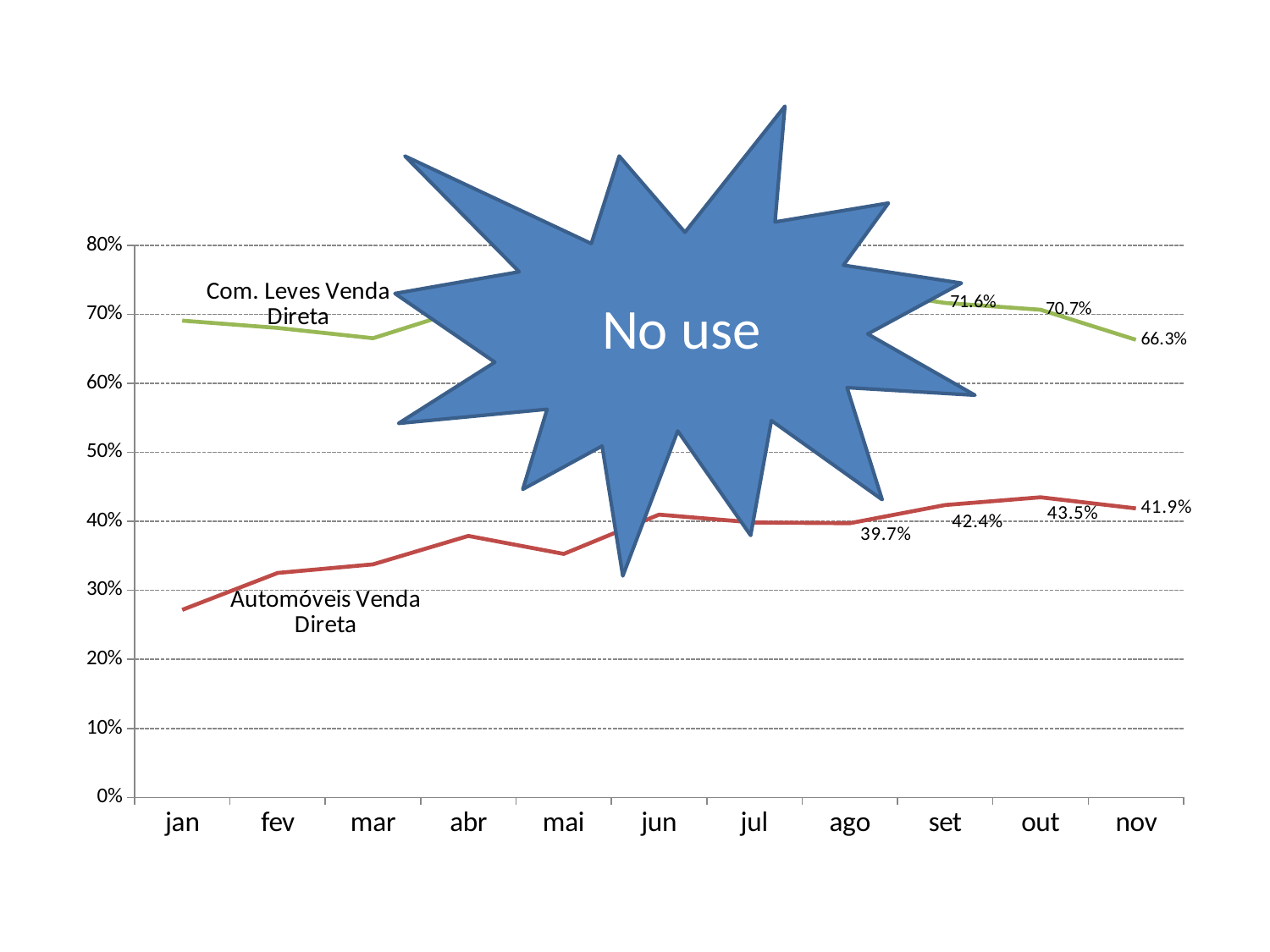
Which series has the higher value in out, Com. Leves Venda Direta or Automóveis Venda Direta? Com. Leves Venda Direta Does the Com. Leves Venda Direta line rise or fall from set to nov? fall Is the value for Automóveis Venda Direta in jan greater or less than 30%? less What text is written inside the large blue star shape covering the chart? No use What kind of chart is shown on the slide? line chart What is the difference between Com. Leves Venda Direta and Automóveis Venda Direta in nov? 24.4% What is the value for Com. Leves Venda Direta in nov? 66.3% What is the difference between the Automóveis Venda Direta values in out and set? 1.1% What is the value for Com. Leves Venda Direta in set? 71.6% What is the value for Automóveis Venda Direta in out? 43.5% What is the value for Automóveis Venda Direta in ago? 39.7% How many months are shown on the x axis? 11